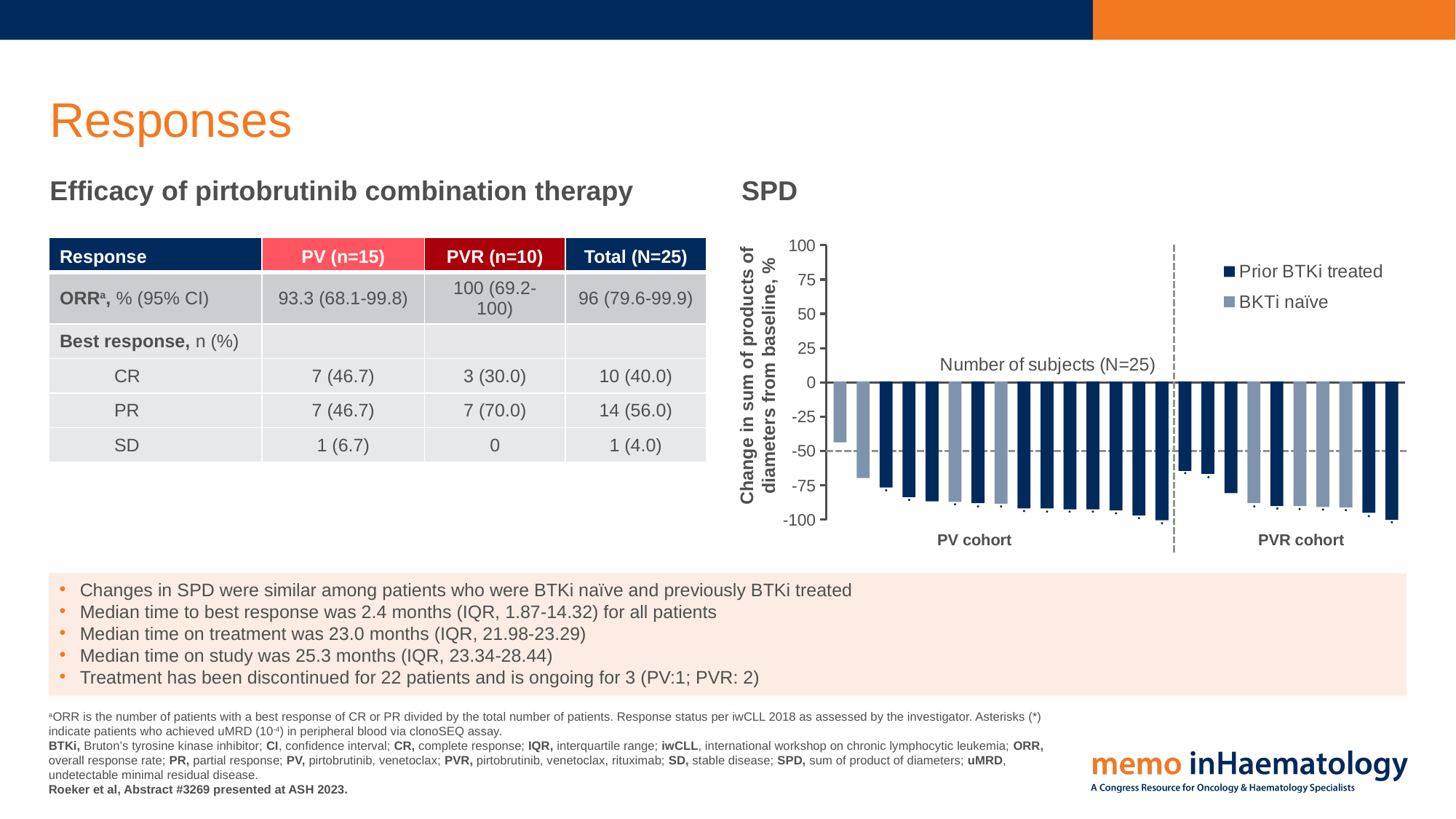
What is the y-axis title of the SPD chart? Change in sum of products of diameters from baseline, % In the SPD chart, do the bar values in the PV cohort generally rise or fall from left to right? fall How many subjects are plotted in the SPD chart? 25 Which two cohorts are labelled on the x axis of the SPD chart? PV cohort and PVR cohort How many series does the legend of the SPD chart list? 2 In the SPD chart, which bar in the PV cohort has the highest (least negative) value, the first or the last? the first What are the two legend entries in the SPD chart? Prior BTKi treated; BKTi naïve In the SPD chart, is the value for the first bar of the PV cohort greater or less than -50? greater What kind of chart is the SPD chart? Bar chart In the SPD chart, is the value for the last bar of the PVR cohort greater or less than -75? less In the SPD chart, is the value for the second bar of the PV cohort greater or less than -50? less